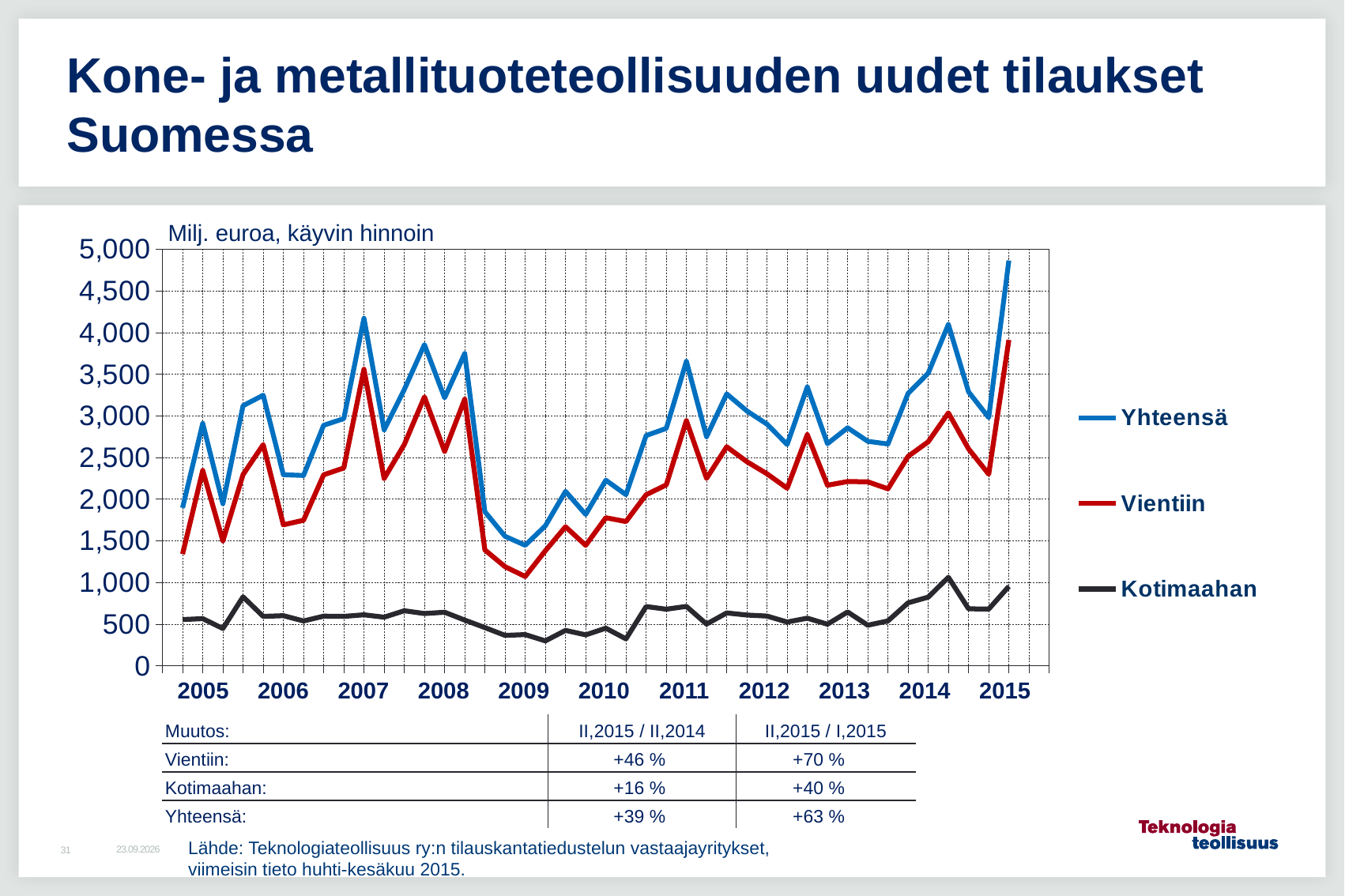
Which series has the lowest values throughout the chart? Kotimaahan Which is larger at the end of 2015, Yhteensä or Vientiin? Yhteensä How many series does the chart legend list? 3 Is the last plotted value of Vientiin in 2015 greater or less than 3,500? greater Is the last plotted value of Yhteensä in 2015 greater or less than 4,500? greater Which series reaches the highest value on the chart? Yhteensä Do the Yhteensä values rise or fall from the end of 2008 into 2009? fall What unit is given above the chart's y axis? Milj. euroa, käyvin hinnoin Is the lowest value of Vientiin in 2009 greater or less than 1,500? less Which series is plotted with the red line? Vientiin What kind of chart is shown on the slide? line chart